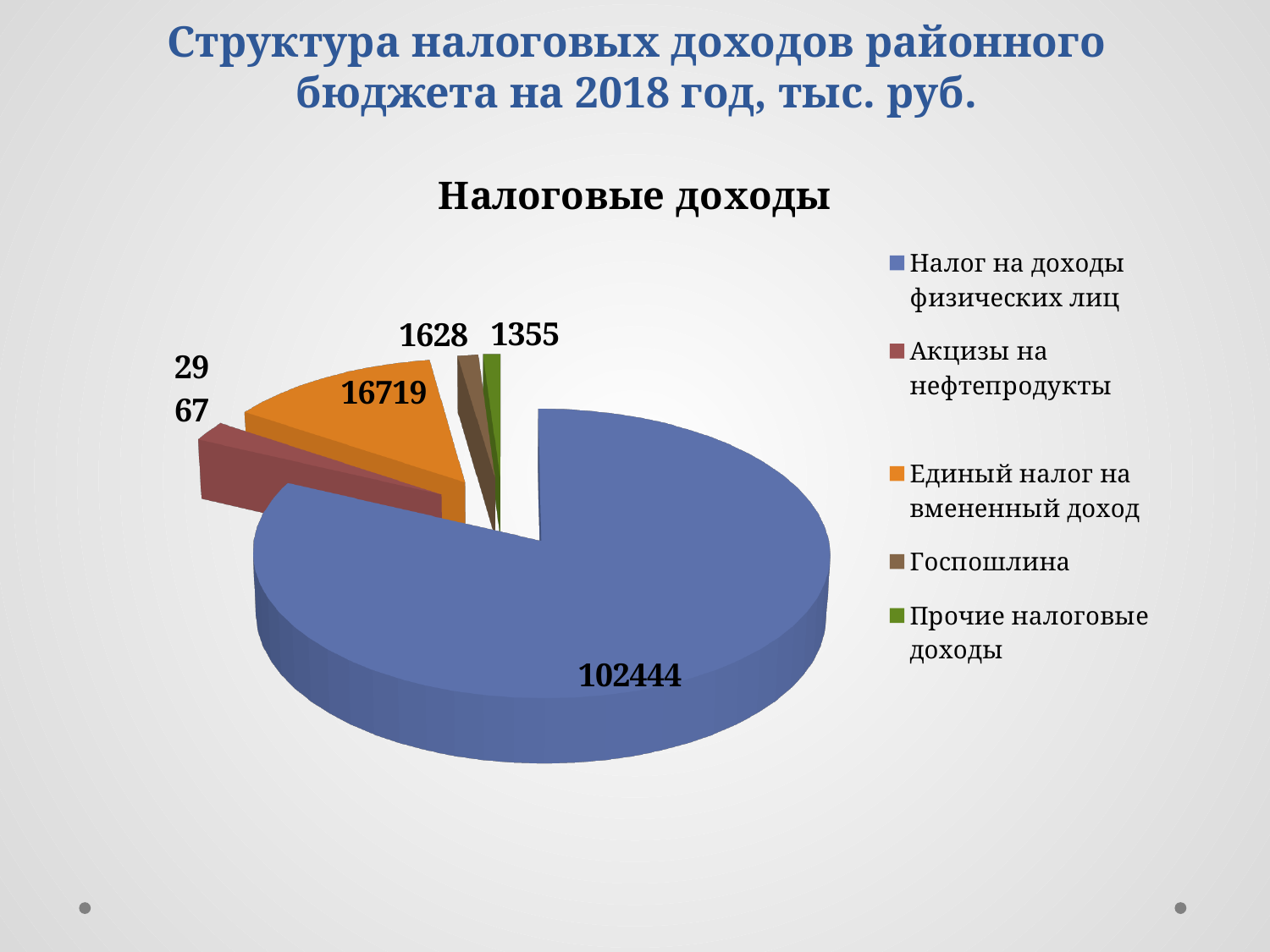
What is the value for Прочие налоговые доходы? 1355 What is the value for Налог на доходы физических лиц? 102444 Which is larger, the value for Госпошлина or the value for Прочие налоговые доходы? Госпошлина What kind of chart is shown on the slide? pie chart How many slices does the pie chart have? 5 How many entries does the legend list? 5 What is the difference between the values for Единый налог на вмененный доход and Госпошлина? 15091 What is the value for Единый налог на вмененный доход? 16719 Which category has the largest slice of the pie? Налог на доходы физических лиц Which category has the smallest slice of the pie? Прочие налоговые доходы What is the value for Госпошлина? 1628 What is the title of the pie chart? Налоговые доходы